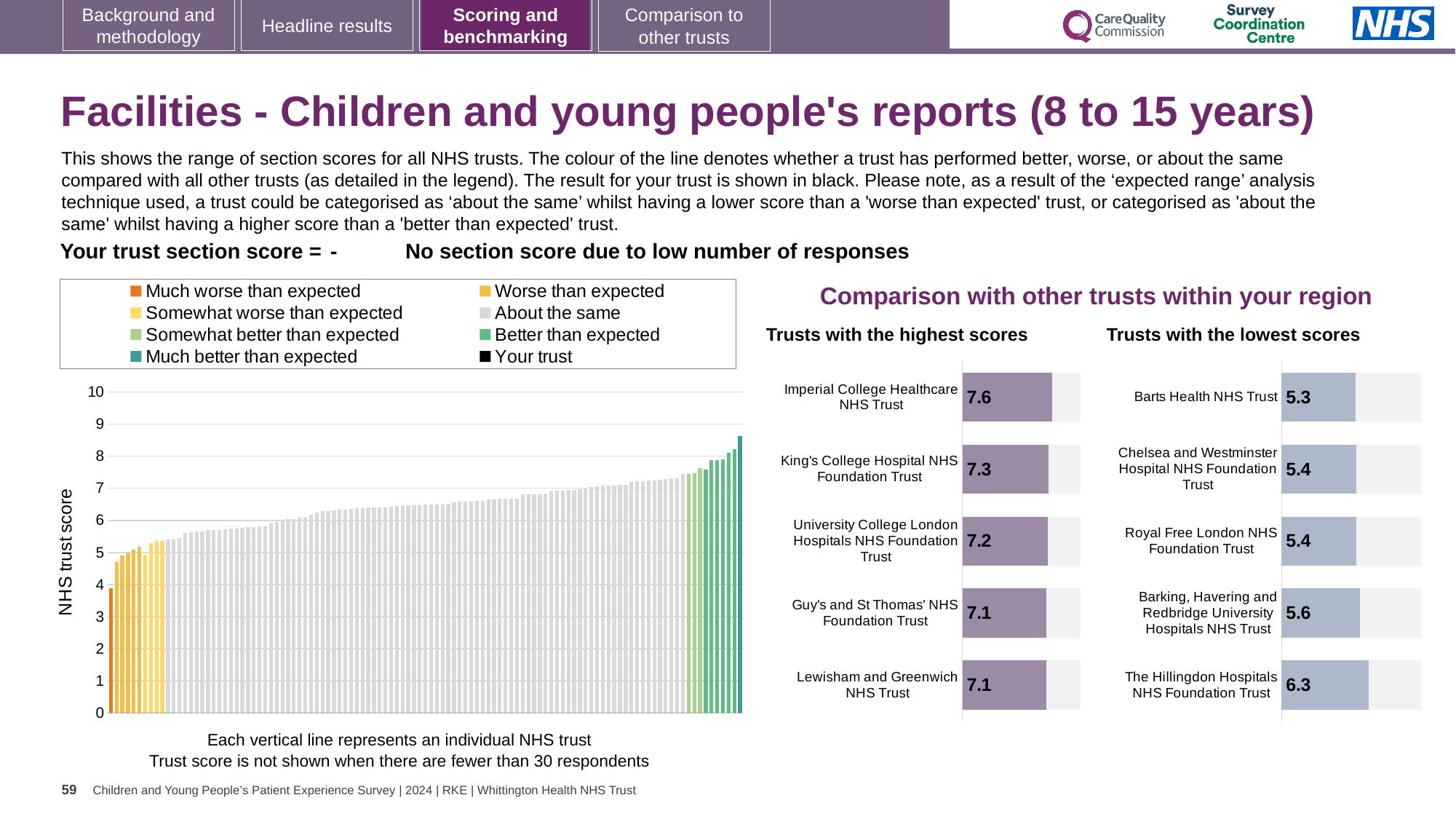
How many trusts are shown in the 'Trusts with the lowest scores' chart? 5 In the 'Trusts with the highest scores' chart, which trust has the highest score? Imperial College Healthcare NHS Trust In the 'Trusts with the highest scores' chart, what is the score for King's College Hospital NHS Foundation Trust? 7.3 In the 'Trusts with the lowest scores' chart, which trust has the lowest score? Barts Health NHS Trust In the 'Trusts with the lowest scores' chart, what is the score for Barts Health NHS Trust? 5.3 In the 'Trusts with the highest scores' chart, what is the difference between the scores of Imperial College Healthcare NHS Trust and University College London Hospitals NHS Foundation Trust? 0.4 In the main 'NHS trust score' chart, is the value of the tallest bar on the right greater or less than 8? greater How many entries does the legend of the main 'NHS trust score' chart list? 8 In the 'Trusts with the highest scores' chart, what is the score for Imperial College Healthcare NHS Trust? 7.6 What kind of chart is the main chart with the 'NHS trust score' axis? Bar chart In the 'Trusts with the lowest scores' chart, which has the larger score: Barking, Havering and Redbridge University Hospitals NHS Trust or Royal Free London NHS Foundation Trust? Barking, Havering and Redbridge University Hospitals NHS Trust In the 'Trusts with the lowest scores' chart, what is the score for The Hillingdon Hospitals NHS Foundation Trust? 6.3